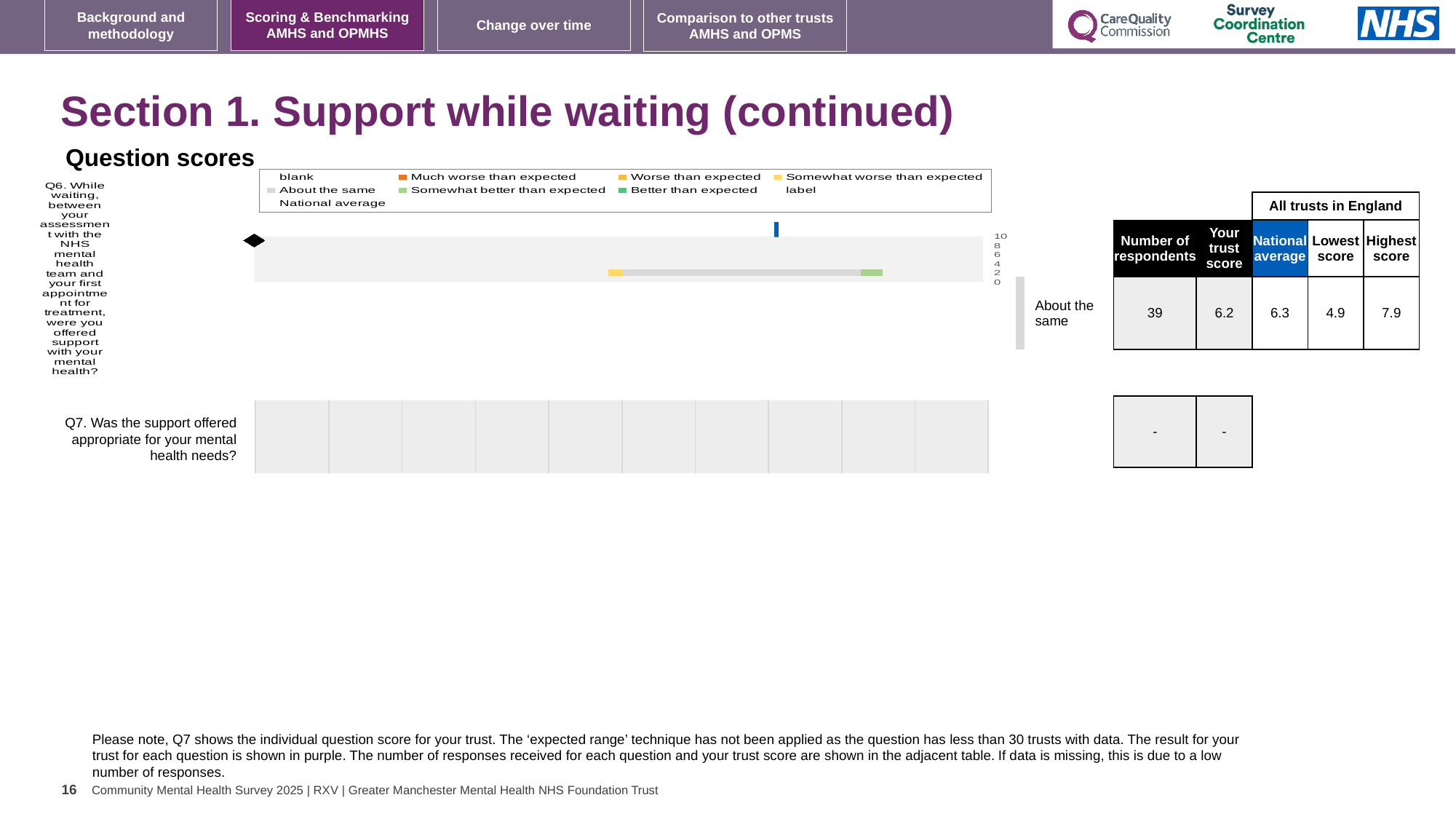
Is the trust score for Q6 greater or less than 4? greater What is the trust score for Q6 shown in the table? 6.2 How many respondents answered Q6? 39 What colour does the legend use for 'Better than expected'? green Which expected-range category is the trust's Q6 result labelled as? About the same What is the lowest score among all trusts in England for Q6? 4.9 What is the highest score among all trusts in England for Q6? 7.9 Which is larger for Q6, the trust score or the national average? national average What is the difference between the national average and the trust score for Q6? 0.1 What is the difference between the highest score and the lowest score for Q6? 3.0 What is the national average score for Q6? 6.3 What kind of chart is used to show the Q6 question score? bar chart